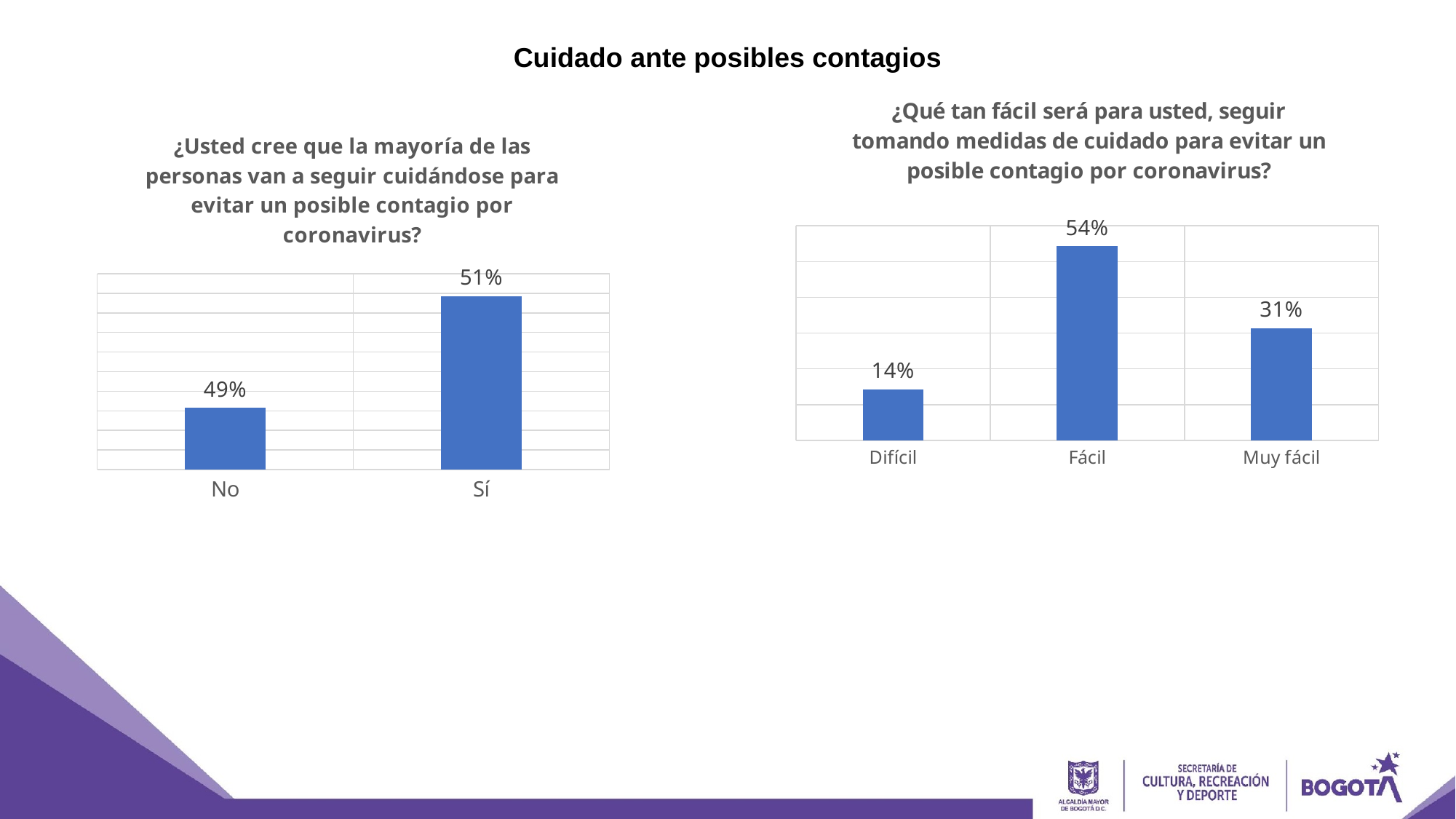
In the right chart (¿Qué tan fácil será para usted, seguir tomando medidas de cuidado...?), what is the value for "Fácil"? 54% In the left chart (¿Usted cree que la mayoría de las personas van a seguir cuidándose...?), how many categories are shown? 2 In the right chart (¿Qué tan fácil será para usted, seguir tomando medidas de cuidado...?), what is the value for "Muy fácil"? 31% In the right chart (¿Qué tan fácil será para usted, seguir tomando medidas de cuidado...?), what is the value for "Difícil"? 14% In the right chart (¿Qué tan fácil será para usted, seguir tomando medidas de cuidado...?), what is the difference between the values for "Fácil" and "Muy fácil"? 23% In the left chart (¿Usted cree que la mayoría de las personas van a seguir cuidándose...?), what is the difference between the values for "Sí" and "No"? 2% In the right chart (¿Qué tan fácil será para usted, seguir tomando medidas de cuidado...?), which category has the lowest value? Difícil In the right chart (¿Qué tan fácil será para usted, seguir tomando medidas de cuidado...?), which category has the highest value? Fácil In the right chart (¿Qué tan fácil será para usted, seguir tomando medidas de cuidado...?), which is larger, the value for "Muy fácil" or the value for "Difícil"? Muy fácil In the left chart (¿Usted cree que la mayoría de las personas van a seguir cuidándose...?), what is the value for "Sí"? 51% What type of chart is the right chart (¿Qué tan fácil será para usted, seguir tomando medidas de cuidado...?)? Bar chart In the left chart (¿Usted cree que la mayoría de las personas van a seguir cuidándose...?), what is the value for "No"? 49%